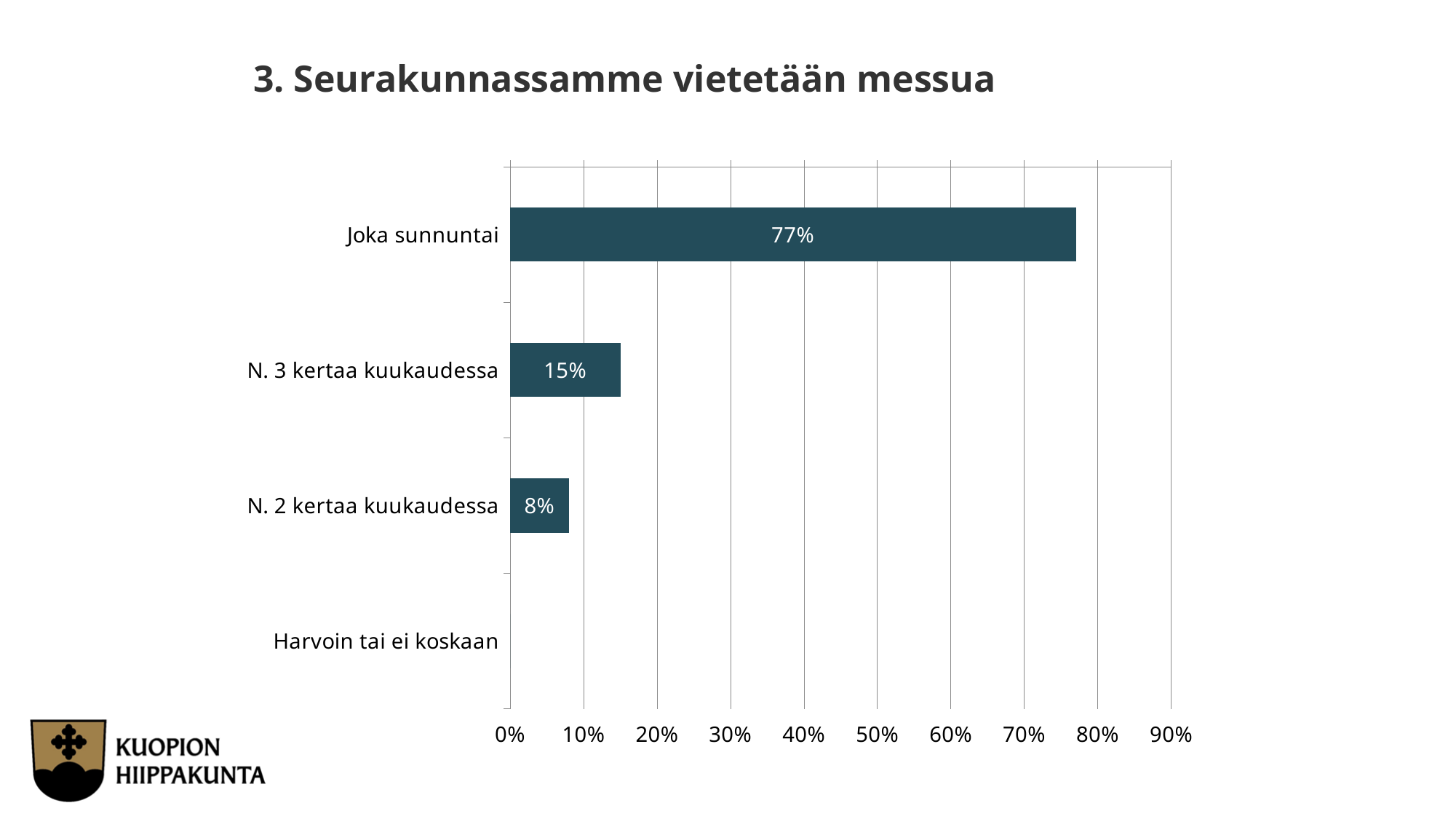
What percentage is shown for "Joka sunnuntai"? 77% What is the value for "N. 2 kertaa kuukaudessa"? 8% Is the value for "Joka sunnuntai" greater or less than 70%? greater What is the difference between the values for "N. 3 kertaa kuukaudessa" and "N. 2 kertaa kuukaudessa"? 7% What is the difference between the values for "Joka sunnuntai" and "N. 3 kertaa kuukaudessa"? 62% Which is larger, the value for "N. 3 kertaa kuukaudessa" or "N. 2 kertaa kuukaudessa"? N. 3 kertaa kuukaudessa What type of chart is shown on the slide? Bar chart Which category has the highest value? Joka sunnuntai What is the title of the chart? 3. Seurakunnassamme vietetään messua How many categories are shown on the chart? 4 What is the value for "N. 3 kertaa kuukaudessa"? 15% Which category has the lowest value? Harvoin tai ei koskaan